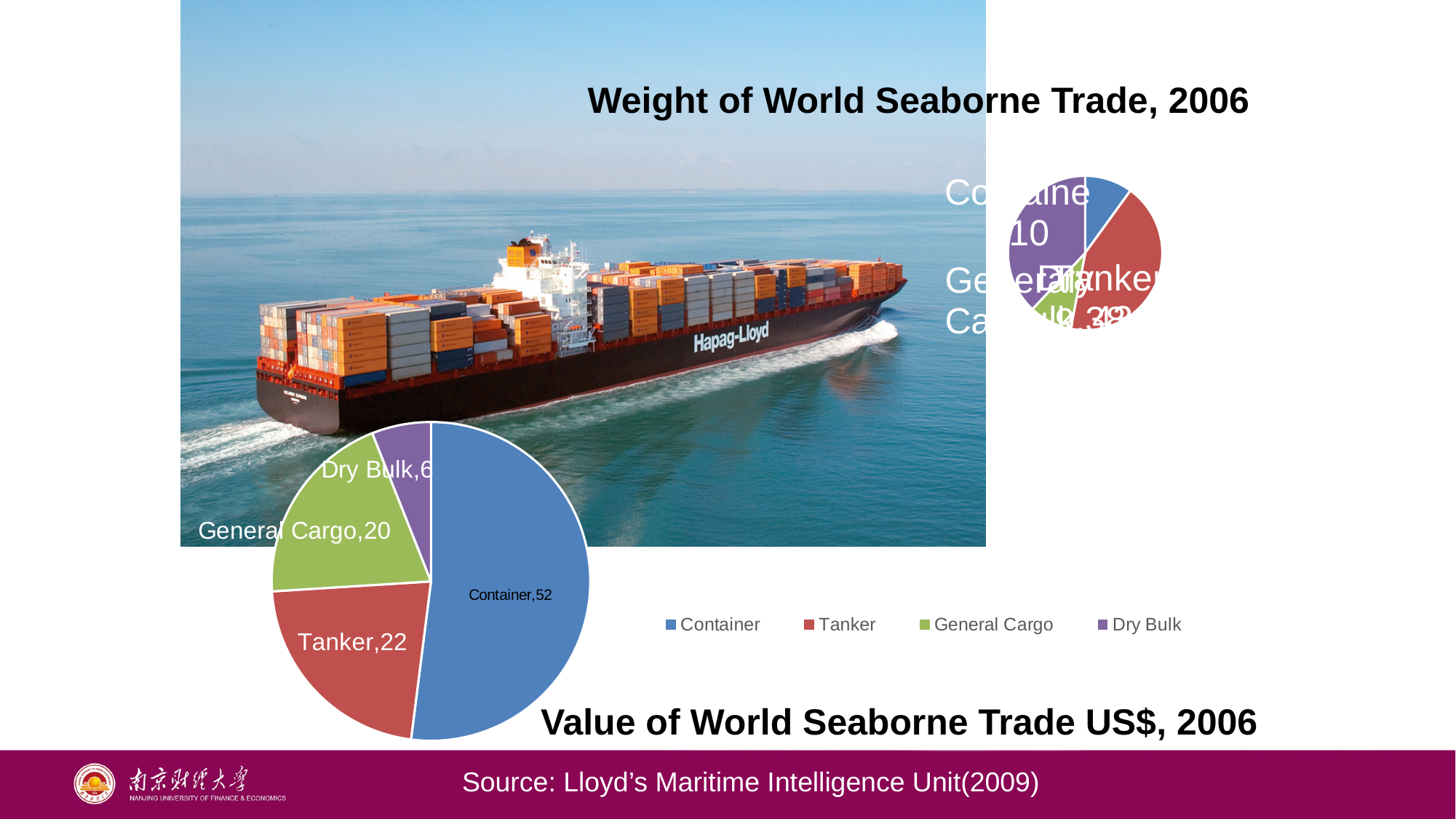
In the Weight of World Seaborne Trade, 2006 chart, which category has the largest slice? Tanker In the Value of World Seaborne Trade US$, 2006 chart, what is the value for Tanker? 22 In the Value of World Seaborne Trade US$, 2006 chart, what is the difference between the Container and Tanker values? 30 In the Value of World Seaborne Trade US$, 2006 chart, which category has the largest slice? Container In the Value of World Seaborne Trade US$, 2006 chart, what is the value for Container? 52 In the Value of World Seaborne Trade US$, 2006 chart, which is larger, General Cargo or Dry Bulk? General Cargo In the Weight of World Seaborne Trade, 2006 chart, what is the value for Container? 10 In the Value of World Seaborne Trade US$, 2006 chart, what is the value for Dry Bulk? 6 In the Value of World Seaborne Trade US$, 2006 chart, what is the value for General Cargo? 20 In the Value of World Seaborne Trade US$, 2006 chart, which category has the smallest slice? Dry Bulk What kind of chart is the Value of World Seaborne Trade US$, 2006 chart? Pie chart How many categories does the Value of World Seaborne Trade US$, 2006 chart show? 4